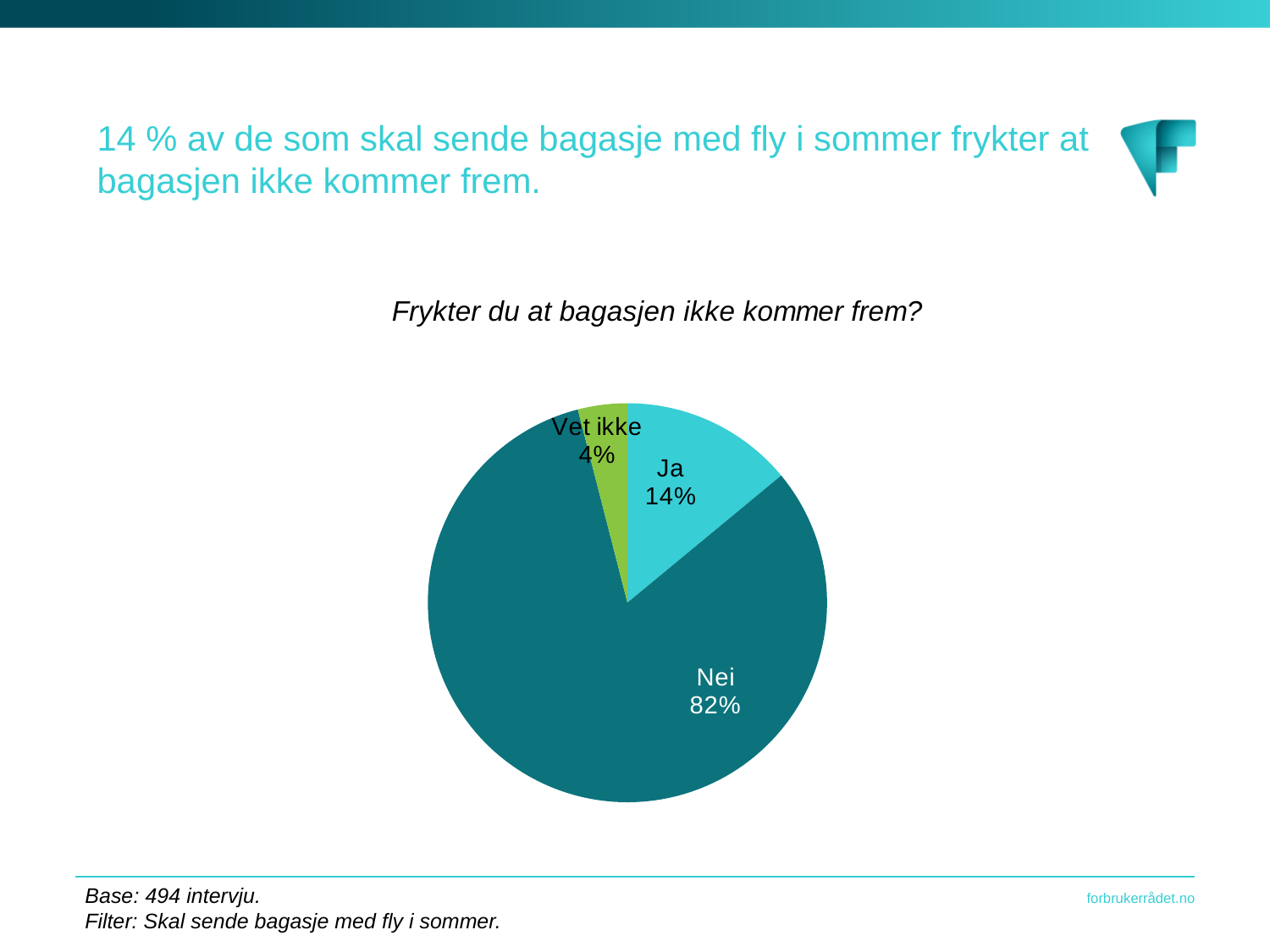
What colour is the "Vet ikke" slice? Green What percentage of respondents answered "Nei"? 82% What kind of chart is shown on the slide? Pie chart Which answer has the largest share of the pie? Nei How many slices does the pie chart have? 3 What is the title of the pie chart? Frykter du at bagasjen ikke kommer frem? What percentage of respondents answered "Vet ikke"? 4% What is the difference in percentage points between "Ja" and "Vet ikke"? 10 What percentage of respondents answered "Ja"? 14% Which is larger, the share for "Ja" or the share for "Vet ikke"? Ja What is the difference in percentage points between "Nei" and "Ja"? 68 Which answer has the smallest share of the pie? Vet ikke